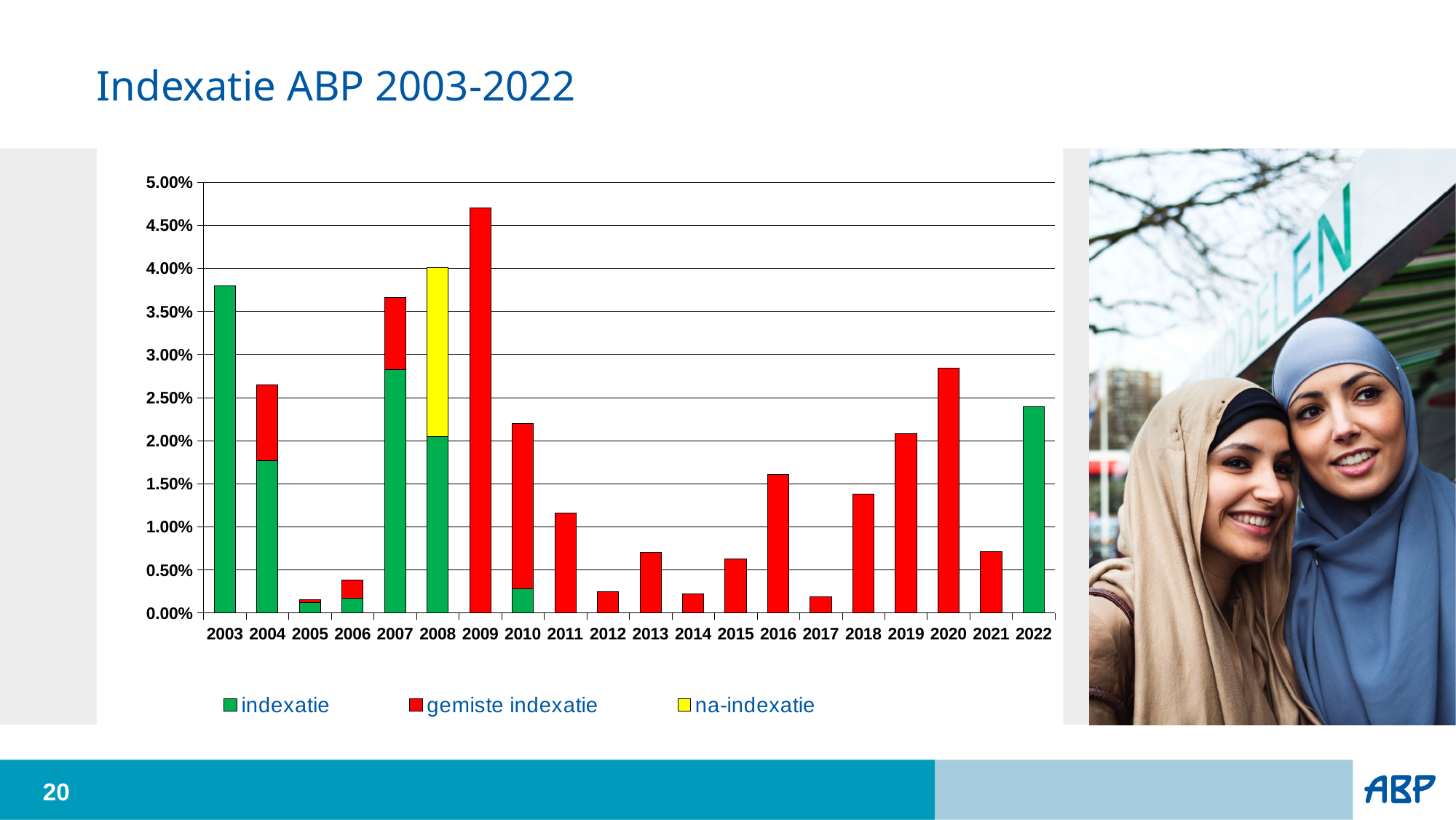
Which year has a larger indexatie (green) value, 2003 or 2022? 2003 Is the value for 2011 greater or less than 1.00%? greater Is the total bar height for 2020 greater or less than 3.00%? less Which year has the tallest bar overall? 2009 How many series does the legend list? 3 Is the value for 2009 greater or less than 4.50%? greater Which bar is taller, 2019 or 2016? 2019 In which year does the na-indexatie (yellow) segment appear? 2008 How many years are shown on the x axis? 20 What kind of chart is shown on the slide? Bar chart